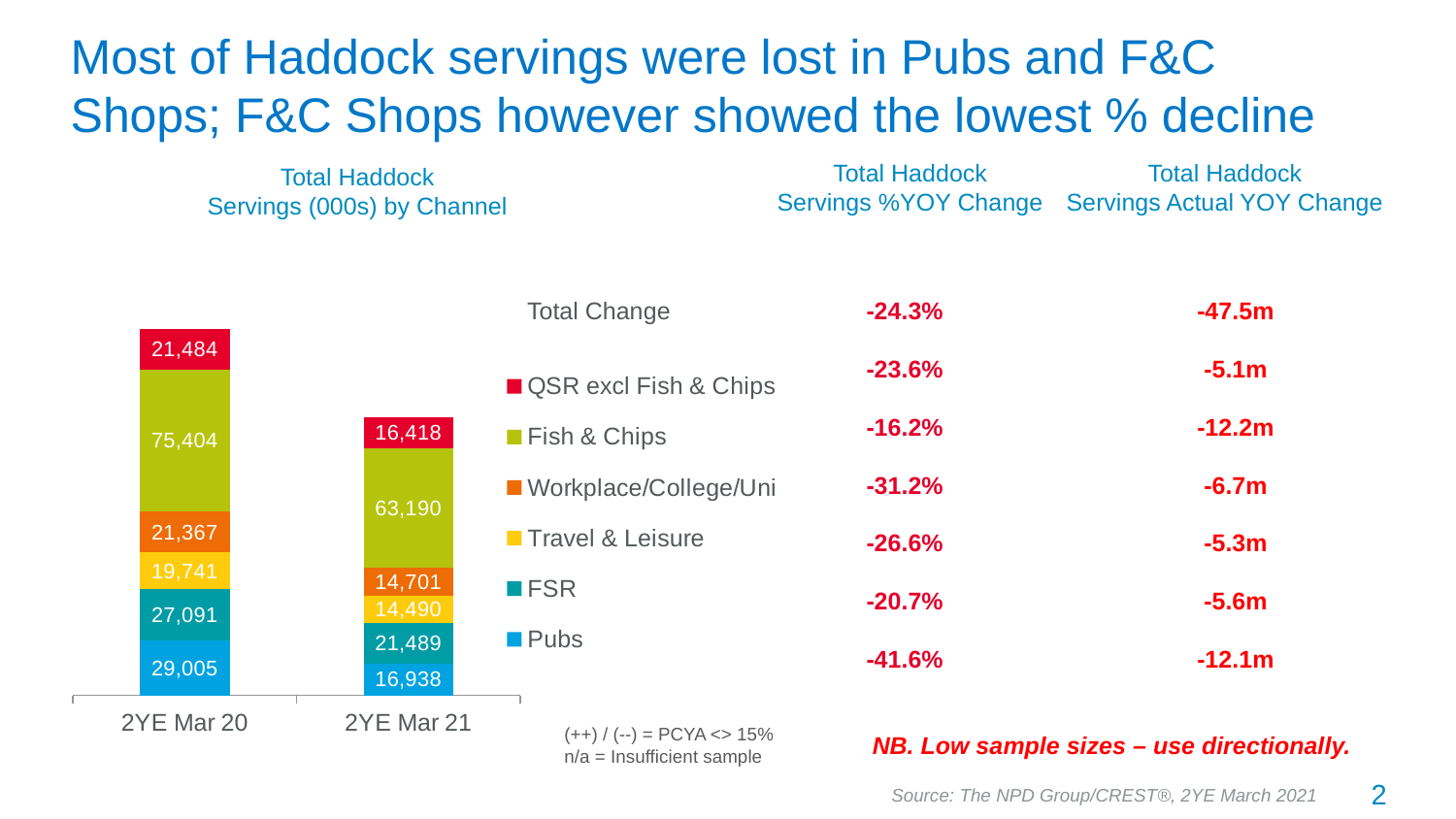
How many bars (time periods) are shown in the Total Haddock Servings (000s) by Channel chart? 2 Which colour represents Pubs in the chart legend? Blue Which is larger: FSR in 2YE Mar 20 or FSR in 2YE Mar 21? FSR in 2YE Mar 20 How many series does the legend of the Total Haddock Servings (000s) by Channel chart list? 6 Which channel has the largest segment in the 2YE Mar 20 bar? Fish & Chips What is the value for Fish & Chips in 2YE Mar 20? 75,404 What is the difference between the Fish & Chips values for 2YE Mar 20 and 2YE Mar 21? 12,214 Which channel has the smallest segment in the 2YE Mar 21 bar? Travel & Leisure What kind of chart is shown on the slide? Stacked bar chart What is the value for Workplace/College/Uni in 2YE Mar 21? 14,701 What is the value for Pubs in 2YE Mar 21? 16,938 What is the total of the 2YE Mar 21 stacked bar? 147,226